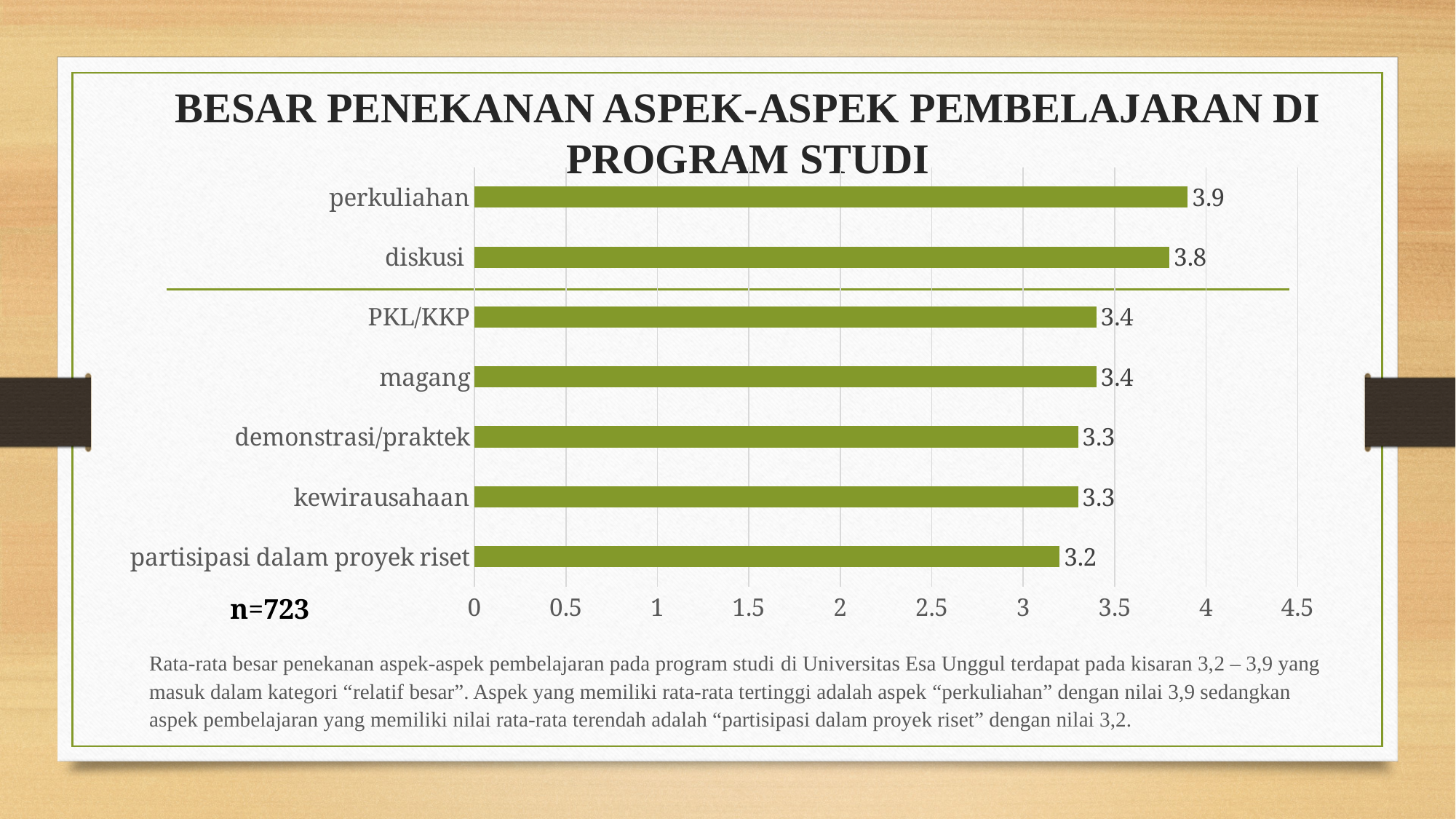
Which category has the lowest value? partisipasi dalam proyek riset What is the value for demonstrasi/praktek? 3.3 What is the difference between the values for perkuliahan and partisipasi dalam proyek riset? 0.7 What is the value for perkuliahan? 3.9 Is the value for kewirausahaan greater or less than 3.5? less Which is larger, the value for diskusi or the value for magang? diskusi What is the value for partisipasi dalam proyek riset? 3.2 What is the difference between the values for diskusi and PKL/KKP? 0.4 What kind of chart is shown on the slide? bar chart How many categories are shown in the chart? 7 What is the value for diskusi? 3.8 Which category has the highest value? perkuliahan